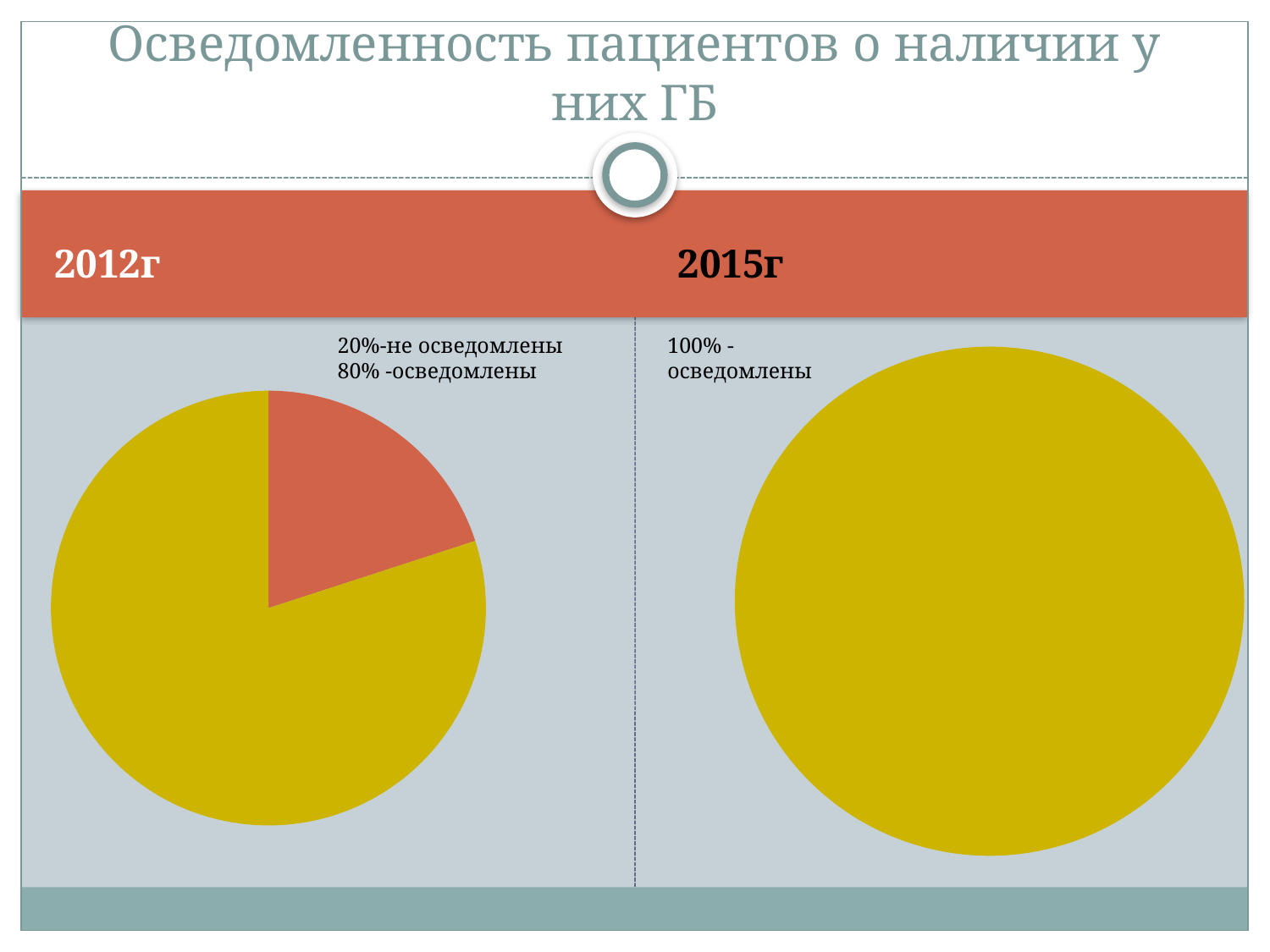
In the 2012г chart, what share of patients are осведомлены (aware)? 80% By how much did the share of осведомлены patients increase from 2012г to 2015г? 20% What is the title of the slide containing the charts? Осведомленность пациентов о наличии у них ГБ What kind of chart is shown for 2012г? pie chart How many slices does the 2015г pie chart have? 1 In the 2015г chart, what share of patients are осведомлены (aware)? 100% What colour is the не осведомлены slice in the 2012г chart? red (orange-red) What is the difference between the осведомлены and не осведомлены shares in the 2012г chart? 60% In the 2012г chart, what share of patients are не осведомлены (not aware)? 20% In the 2012г chart, which slice is larger: осведомлены or не осведомлены? осведомлены Which year's chart shows the higher share of осведомлены patients? 2015г How many slices does the 2012г pie chart have? 2